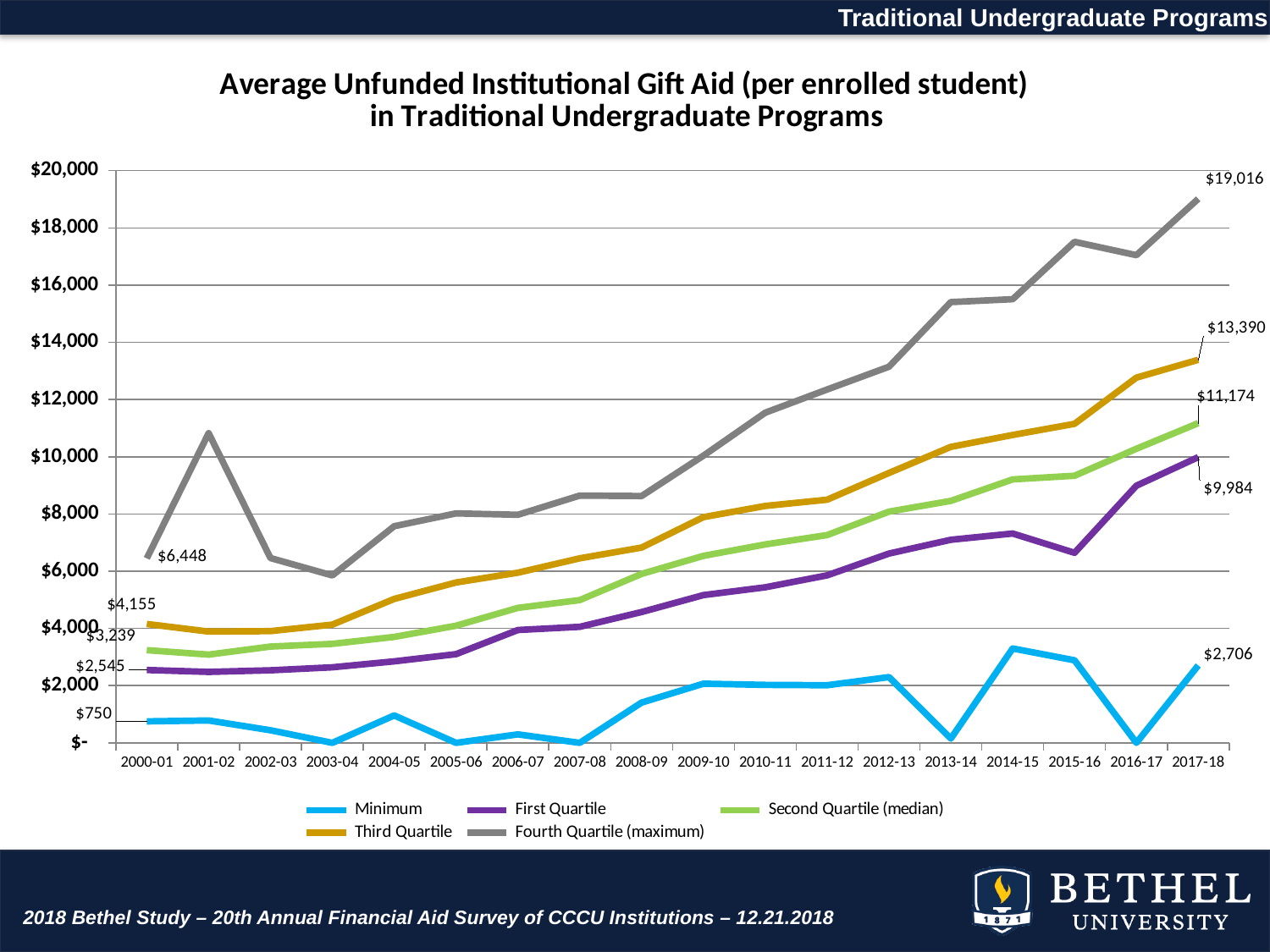
Which series has the highest value in 2017-18? Fourth Quartile (maximum) What is the difference between the Fourth Quartile (maximum) and Minimum values in 2017-18? $16,310 What is the value of the Minimum series in 2000-01? $750 By how much did the First Quartile series increase from 2000-01 to 2017-18? $7,439 What is the value of the Fourth Quartile (maximum) series in 2017-18? $19,016 How many series does the legend list? 5 What is the value of the Second Quartile (median) series in 2000-01? $3,239 What type of chart is shown on the slide? line chart What is the value of the Third Quartile series in 2017-18? $13,390 Does the Third Quartile series generally rise or fall from 2000-01 to 2017-18? rise Is the Fourth Quartile (maximum) value in 2013-14 greater or less than $14,000? greater How many academic years are plotted along the x axis? 18